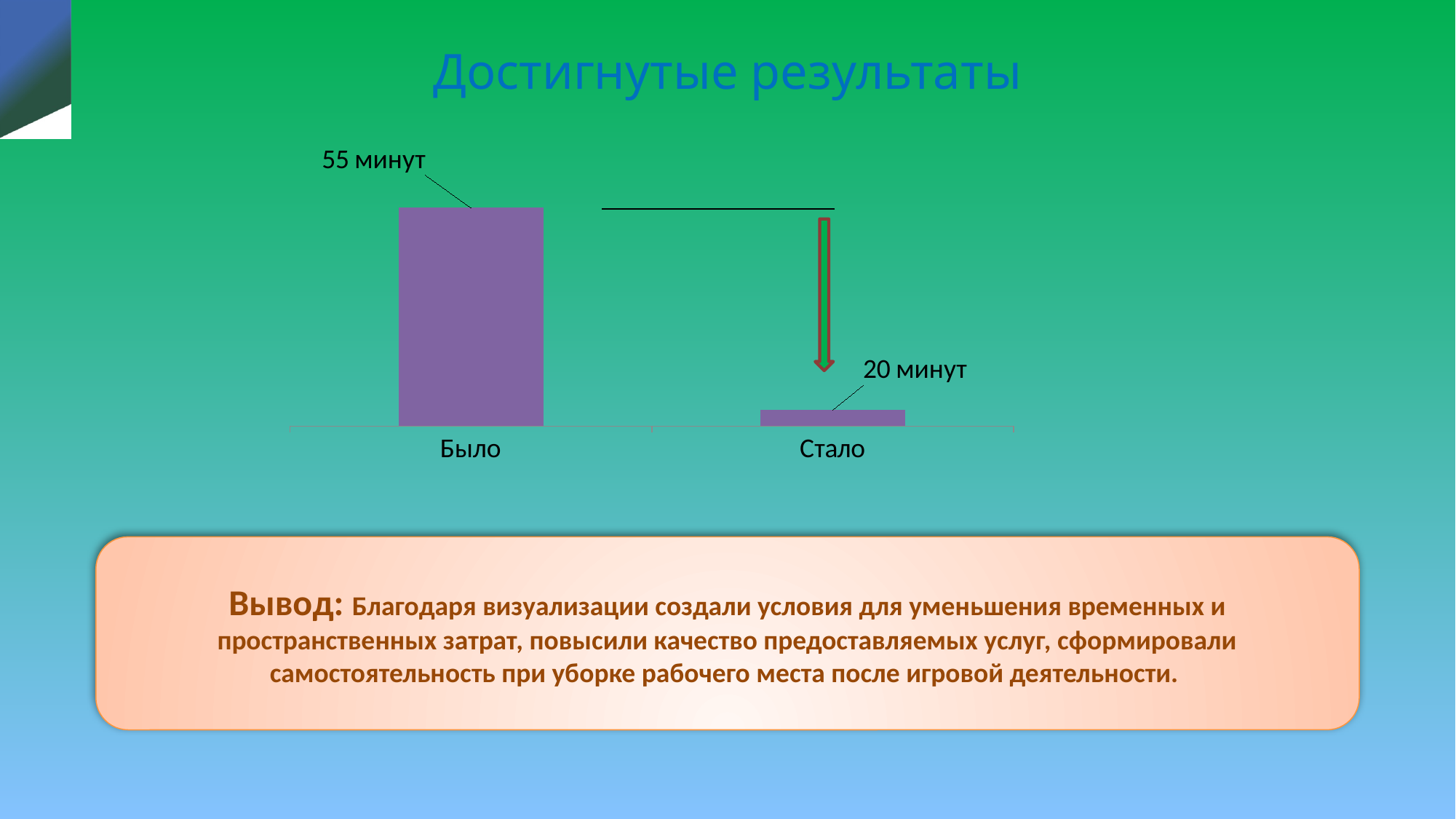
Which category has the lowest value? Стало What kind of chart is shown on the slide? Bar chart Do the values rise or fall from "Было" to "Стало"? Fall How many categories are shown on the chart? 2 What is the title of the slide containing the chart? Достигнутые результаты What is the value for "Было"? 55 минут Which category has the highest value? Было What is the value for "Стало"? 20 минут Which is larger, the value for "Было" or the value for "Стало"? Было What colour are the bars in the chart? Purple What is the difference between the values for "Было" and "Стало"? 35 минут